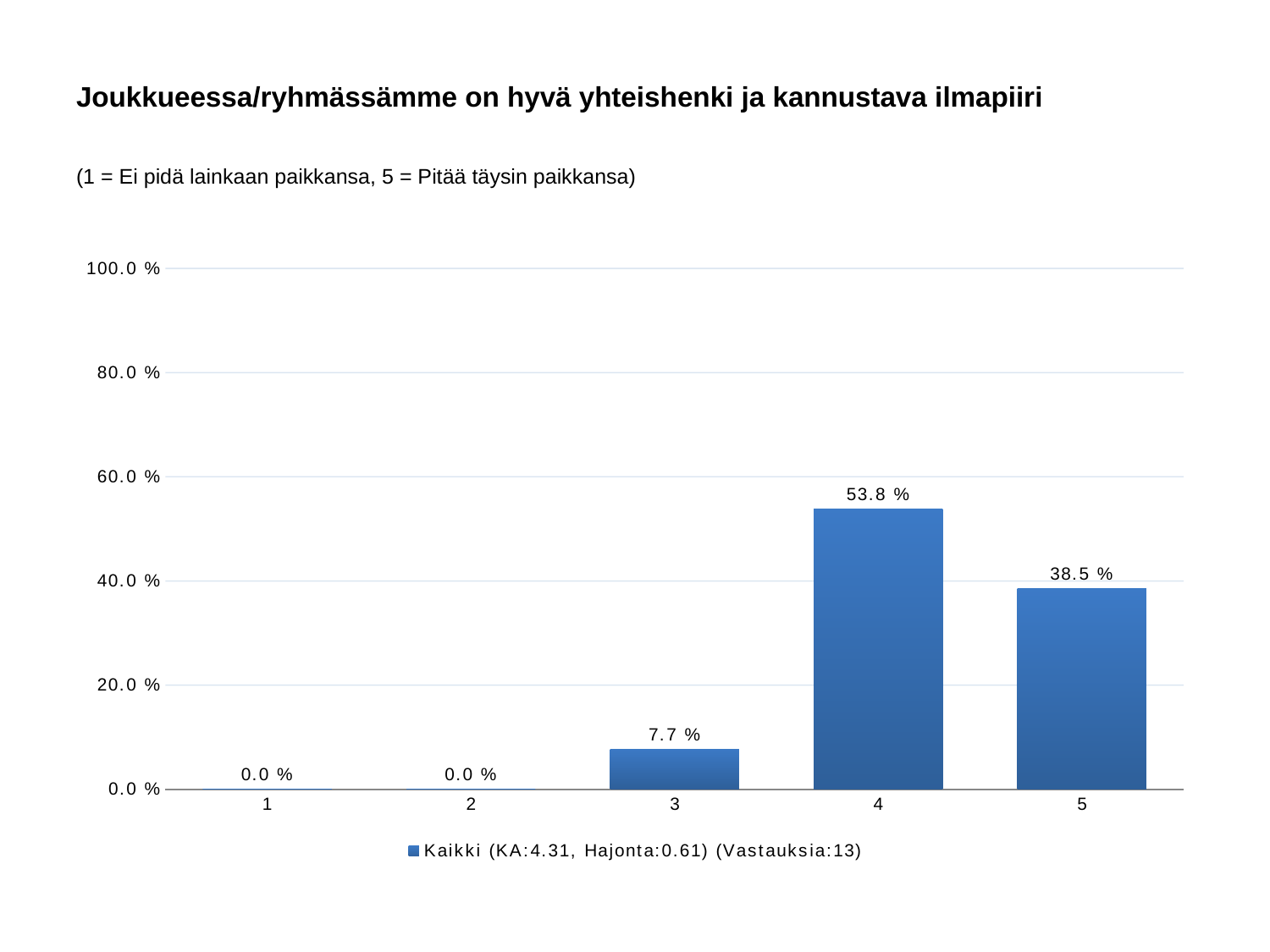
What is the value for category 1? 0.0 % How many categories are shown on the x axis? 5 How many responses (Vastauksia) does the legend report? 13 What is the value for category 5? 38.5 % What is the value for category 4? 53.8 % What is the difference between the values for categories 4 and 5? 15.3 % Which is larger, the value for category 3 or the value for category 5? 5 How many series does the legend list? 1 What is the value for category 3? 7.7 % What kind of chart is shown? bar chart Which category has the highest value? 4 Is the value for category 4 greater or less than 40.0 %? greater